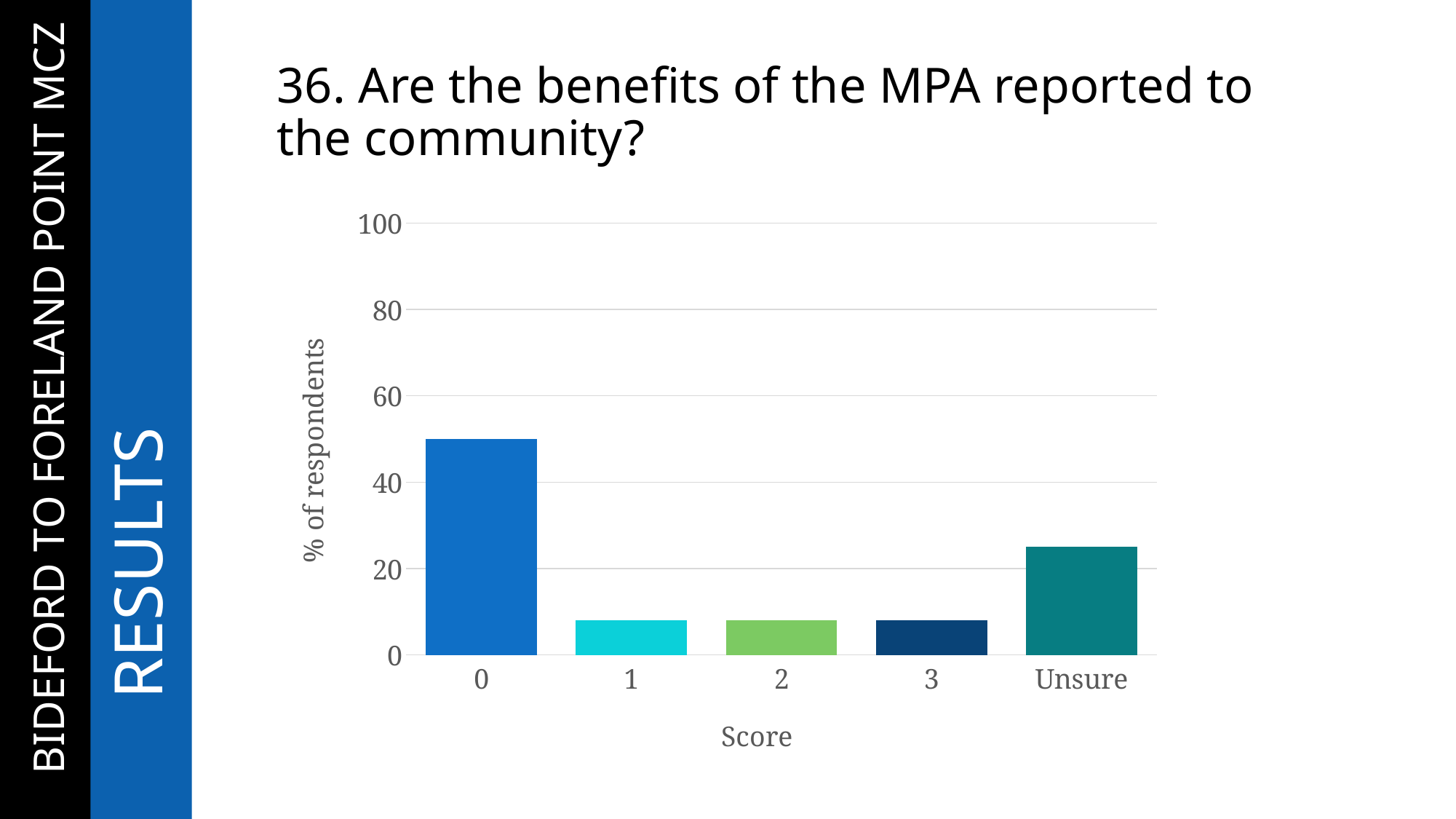
Which score category has the highest percentage of respondents? 0 Is the value for Unsure greater or less than 20? greater Which is larger, the value for Unsure or the value for score 2? Unsure Is the value for Unsure greater or less than 40? less Is the value for score 1 greater or less than 20? less How many score categories are shown on the x axis of the chart? 5 What kind of chart is shown on the slide? bar chart What is the label of the vertical axis of the chart? % of respondents Which is larger, the value for score 0 or the value for Unsure? score 0